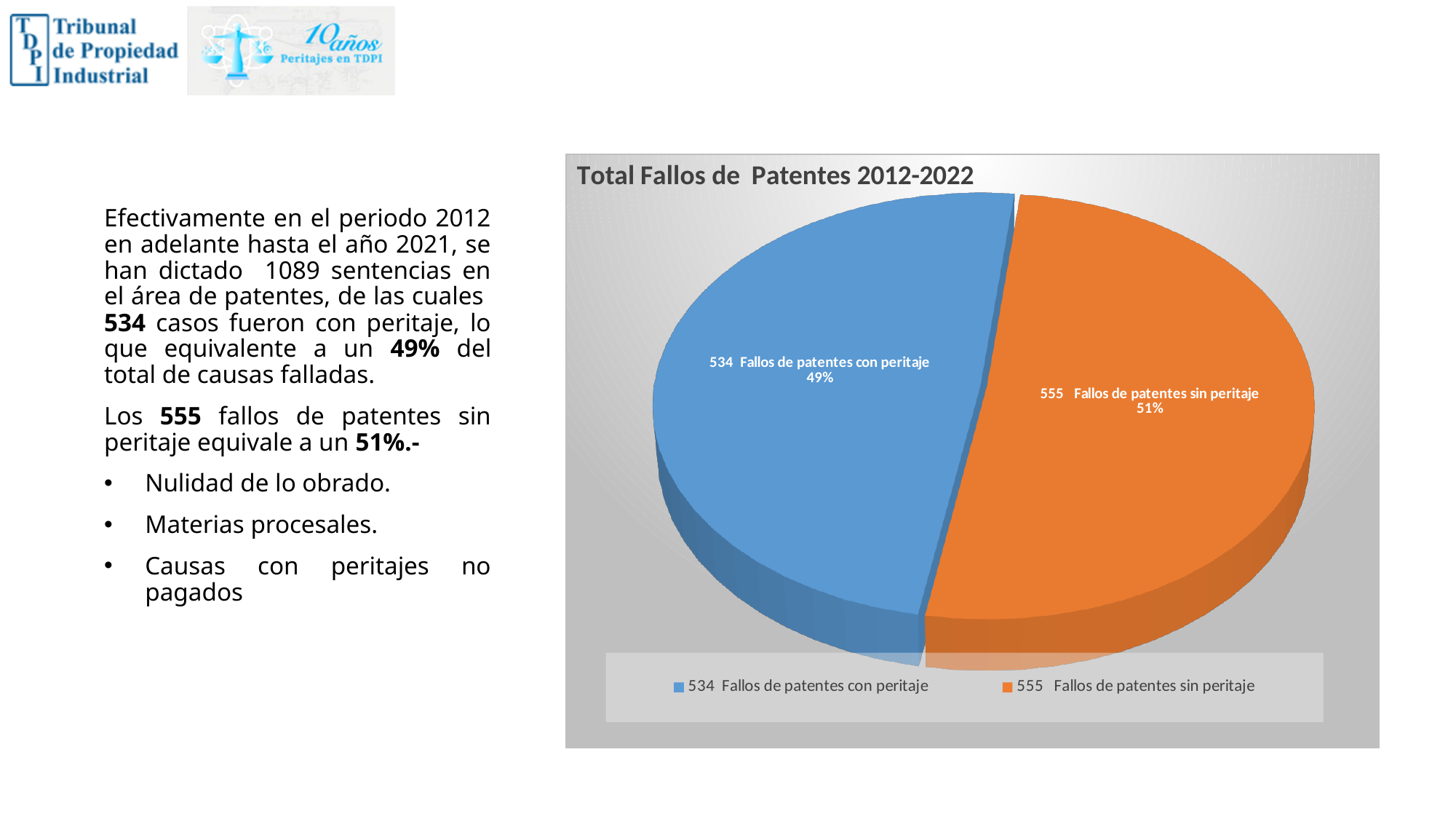
How many 'Fallos de patentes sin peritaje' are shown in the chart? 555 How many slices does the pie chart have? 2 Which slice of the pie is the largest? Fallos de patentes sin peritaje What share of the pie is 'Fallos de patentes sin peritaje'? 51% How many entries does the chart legend list? 2 What colour is the slice for 'Fallos de patentes sin peritaje'? orange How many 'Fallos de patentes con peritaje' are shown in the chart? 534 What is the title of the chart? Total Fallos de Patentes 2012-2022 What is the difference between the number of fallos sin peritaje and fallos con peritaje? 21 Which slice of the pie is the smallest? Fallos de patentes con peritaje What kind of chart is shown on the slide? pie chart What share of the pie is 'Fallos de patentes con peritaje'? 49%